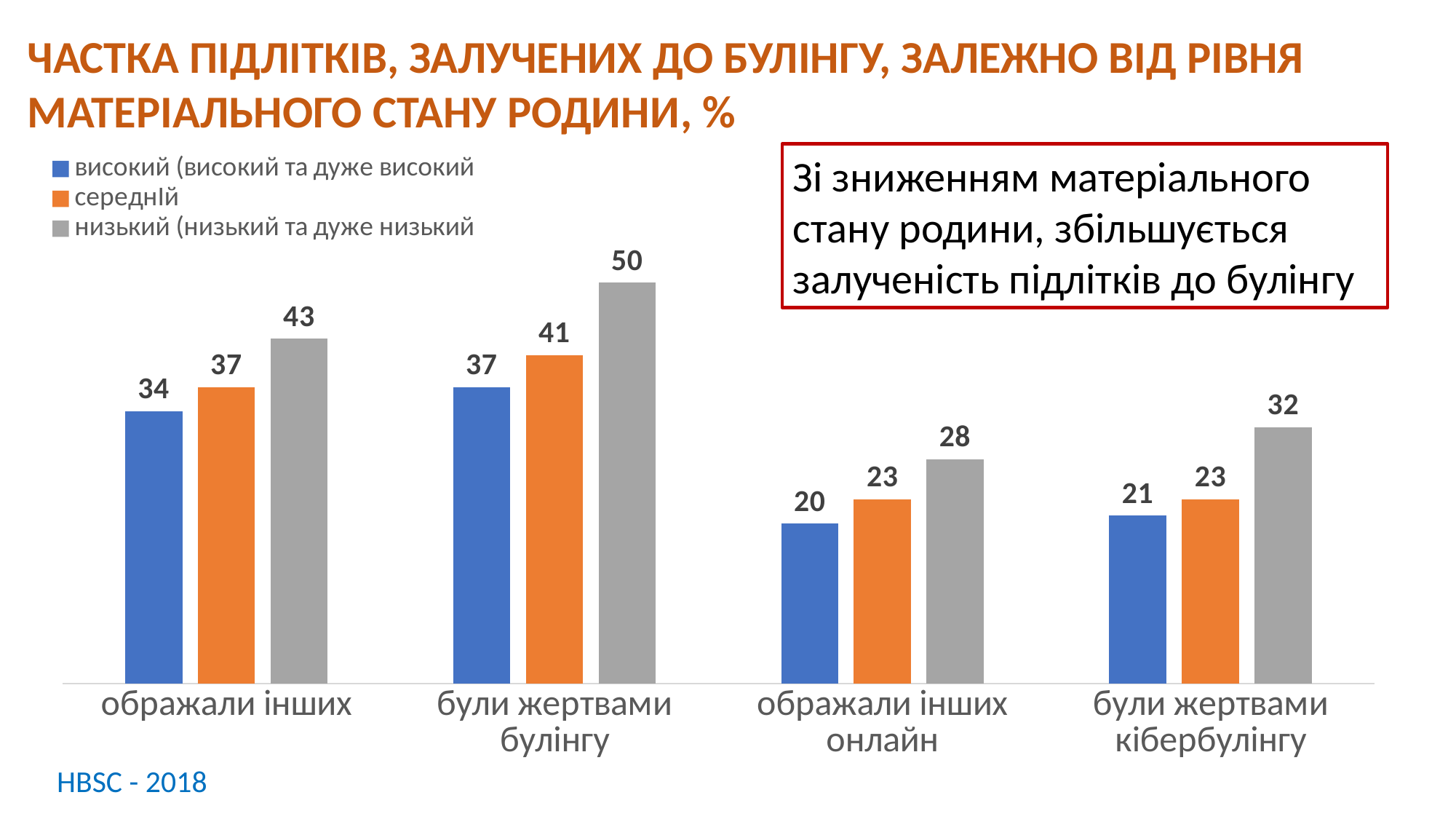
How many series does the legend list? 3 What is the difference between the 'середнІй' values for 'ображали інших' and 'ображали інших онлайн'? 14 How many categories are shown on the x axis? 4 What is the value for the 'високий (високий та дуже високий' series in the 'ображали інших онлайн' category? 20 Which category has the lowest value for the 'високий (високий та дуже високий' series? ображали інших онлайн What is the value for the 'низький (низький та дуже низький' series in the 'були жертвами булінгу' category? 50 What is the value for the 'середнІй' series in the 'були жертвами кібербулінгу' category? 23 What kind of chart is shown on the slide? bar chart Which is larger: the 'низький (низький та дуже низький' value for 'ображали інших' or for 'були жертвами кібербулінгу'? ображали інших Which category has the highest value for the 'низький (низький та дуже низький' series? були жертвами булінгу What is the source noted at the bottom of the slide? HBSC - 2018 What is the difference between the 'низький (низький та дуже низький' and 'високий (високий та дуже високий' values in the 'були жертвами булінгу' category? 13